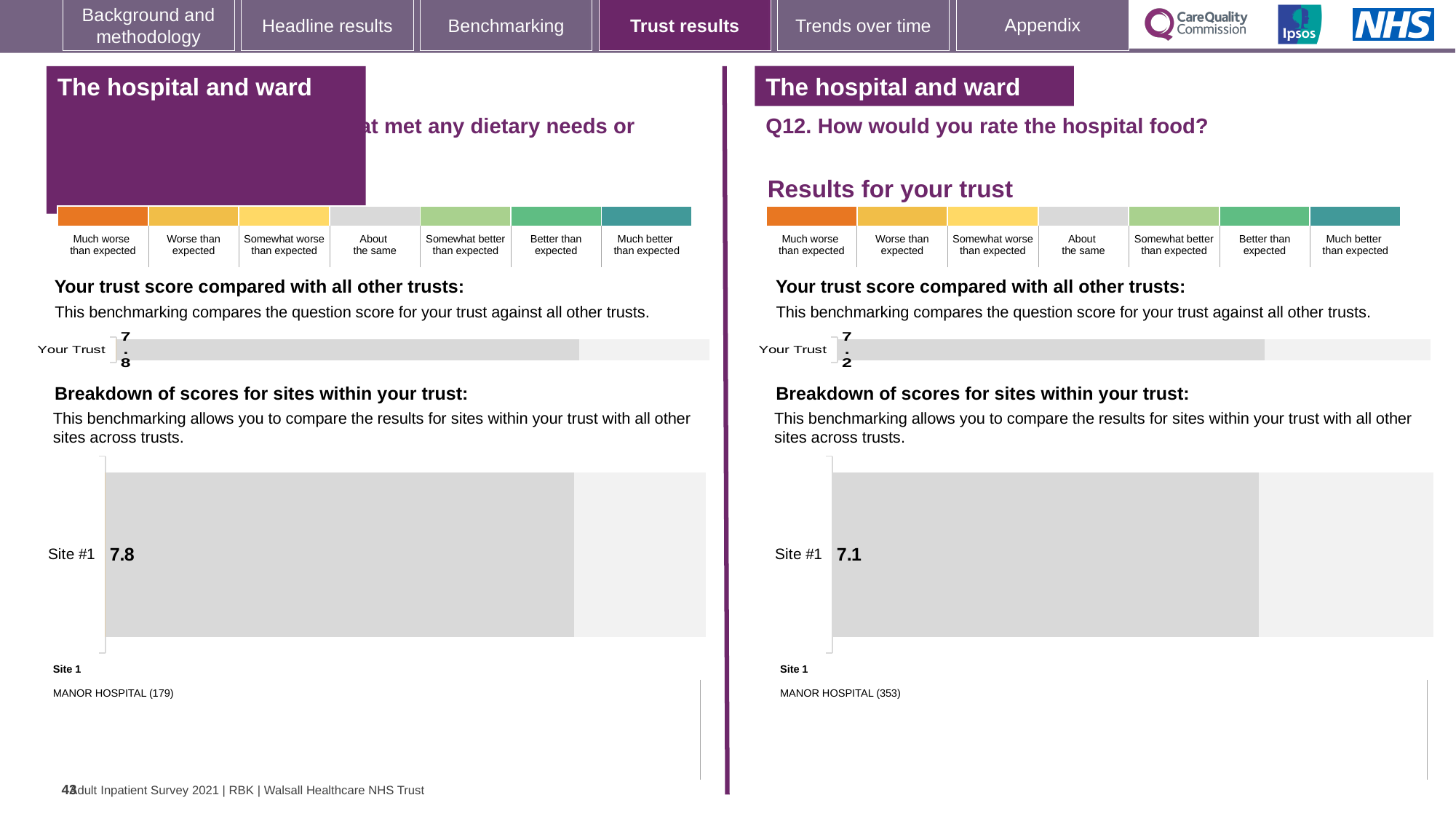
On the left-hand chart, what is the score shown for Your Trust? 7.8 How many sites are shown in the breakdown of scores on the right-hand chart for Q12? 1 On the right-hand chart for Q12 (hospital food), what is the score shown for Your Trust? 7.2 What is the difference between the Site #1 score on the left-hand chart and the Site #1 score on the right-hand chart for Q12? 0.7 What kind of chart is used to show the Site #1 score on the right-hand side for Q12? Bar chart Which site is listed as Site 1 on the right-hand side for Q12? MANOR HOSPITAL (353) Which is larger: the Your Trust score on the left-hand chart or the Your Trust score on the right-hand chart for Q12? Left-hand chart (7.8) Is the Site #1 score on the left-hand chart greater or less than the Site #1 score on the right-hand chart for Q12? greater On the right-hand chart for Q12, what is the difference between the Your Trust score and the Site #1 score? 0.1 On the right-hand chart for Q12 (hospital food), what is the score shown for Site #1? 7.1 Which site is listed as Site 1 on the left-hand side of the slide? MANOR HOSPITAL (179) On the left-hand chart, what is the score shown for Site #1? 7.8